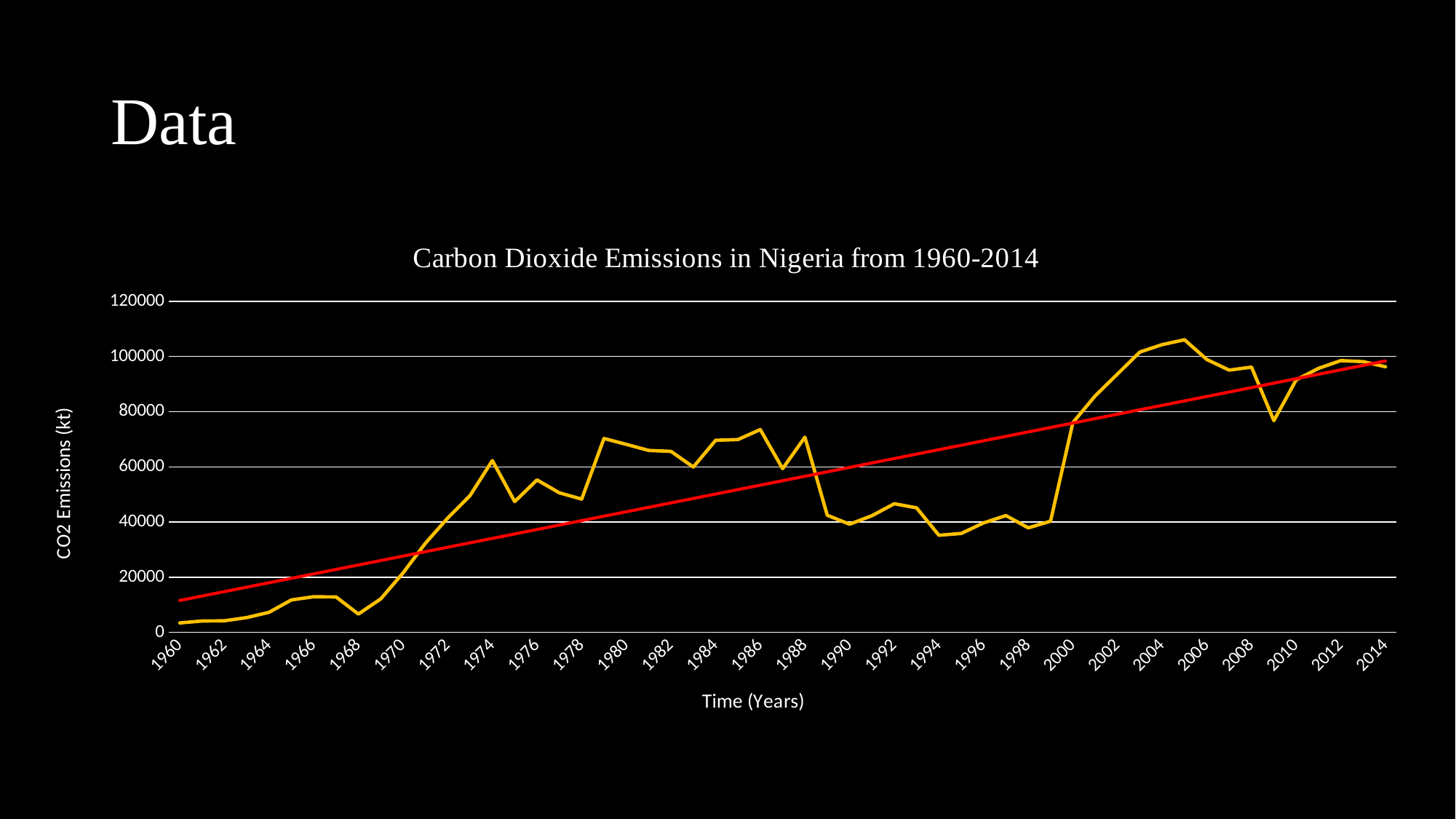
In which year are CO2 emissions lowest on the chart? 1960 Is the value for 1980 greater or less than 60000? greater What is the title of the chart? Carbon Dioxide Emissions in Nigeria from 1960-2014 What type of chart is shown on the slide? Line chart Is the value for 2005 greater or less than 100000? greater Which year has higher CO2 emissions, 1980 or 1990? 1980 Overall, do CO2 emissions rise or fall from 1960 to 2014? Rise What is the label on the vertical axis of the chart? CO2 Emissions (kt) Is the value for 2014 greater or less than 80000? greater In which year do CO2 emissions reach their highest value on the chart? 2005